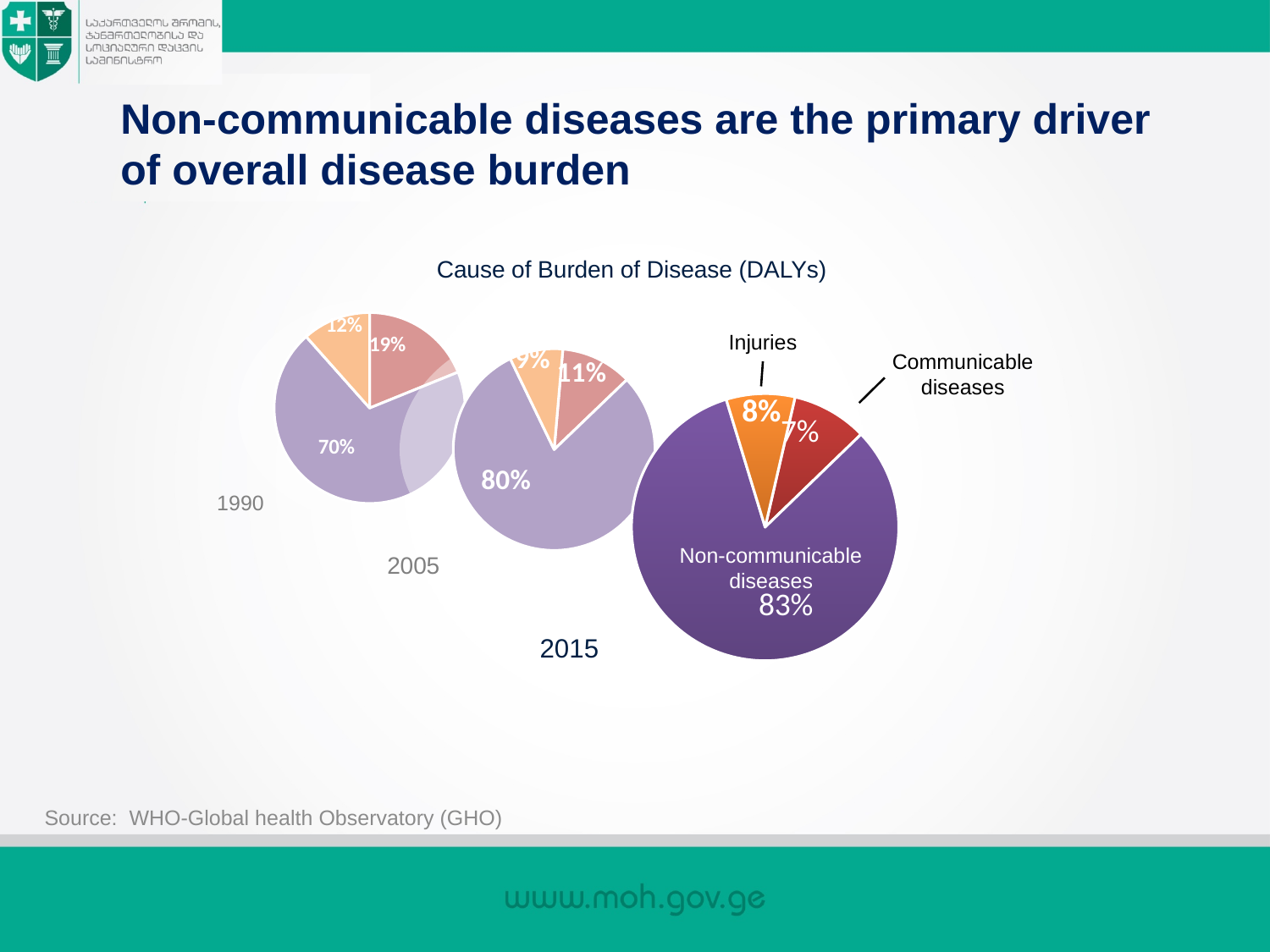
In the 2015 pie chart, which category has the smallest slice? Communicable diseases What is the difference between the largest slice in the 2015 pie chart and the largest slice in the 1990 pie chart? 13 percentage points In the 2015 pie chart, what share is attributed to communicable diseases? 7% In the 2015 pie chart, what share of the burden of disease is attributed to non-communicable diseases? 83% In the 2015 pie chart, which category has the largest slice? Non-communicable diseases How does the largest slice change from the 1990 pie chart to the 2015 pie chart? It rises (70% to 83%) What is the largest percentage shown in the 2005 pie chart? 80% In the 2015 pie chart, what share is attributed to injuries? 8% What kind of charts are shown on the slide under the title 'Cause of Burden of Disease (DALYs)'? Pie charts What is the largest percentage shown in the 1990 pie chart? 70% In the 2015 pie chart, how many slices are there? 3 How many pie charts are shown on the slide? 3